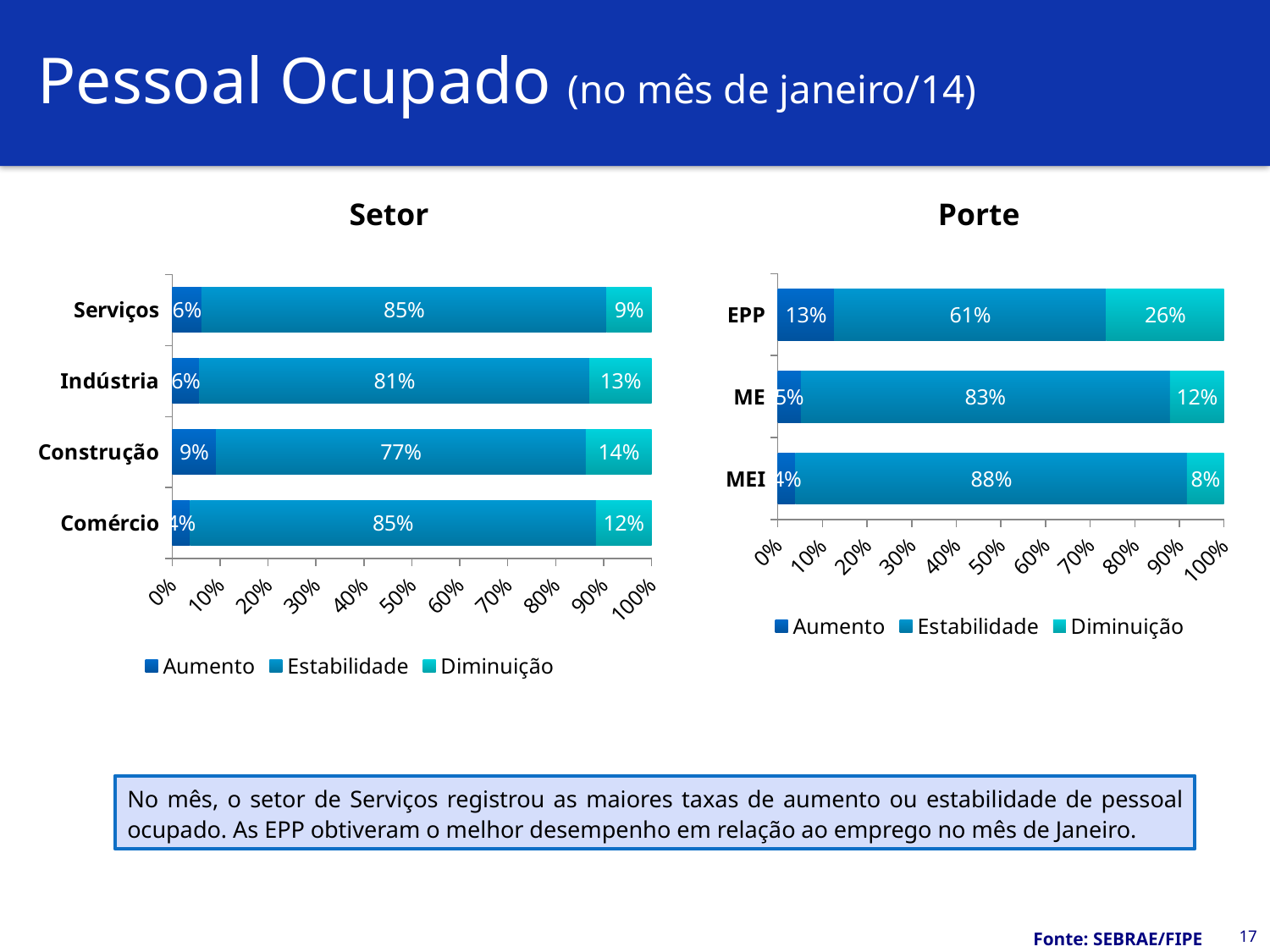
In the Setor chart, what is the Estabilidade value for Indústria? 81% In the Setor chart, which is larger: the Diminuição value for Indústria or for Comércio? Indústria In the Setor chart, what is the total of the Aumento and Estabilidade values for Serviços? 91% In the Porte chart, which size category has the lowest Diminuição value? MEI In the Porte chart, what is the Aumento value for EPP? 13% How many sectors are shown in the Setor chart? 4 In the Porte chart, what is the Estabilidade value for MEI? 88% In the Setor chart, what is the Diminuição value for Construção? 14% In the Porte chart, what is the difference between the Diminuição values for EPP and ME? 14% In the Setor chart, which sector has the highest Aumento value? Construção What kind of chart is the Porte chart? Stacked bar chart How many series does the legend of the Porte chart list? 3